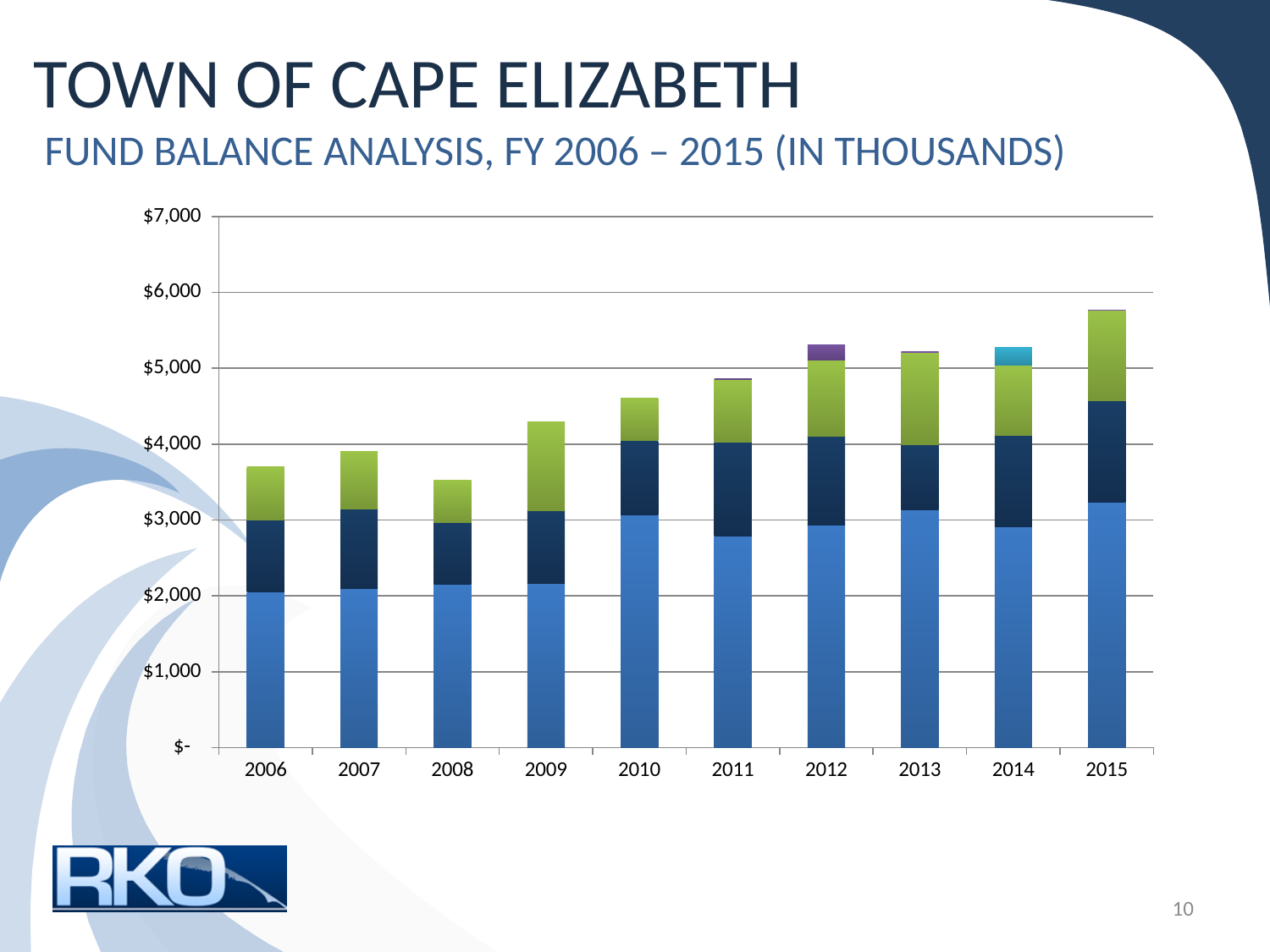
Is the total bar for 2006 greater or less than $4,000? less What kind of chart is shown on the slide? Stacked bar chart Which year has the larger total bar, 2008 or 2009? 2009 Do the total bars generally rise or fall from 2006 to 2015? Rise What is the highest value shown on the vertical axis? $7,000 Is the total bar for 2015 greater or less than $5,000? greater Is the total bar for 2010 greater or less than $4,000? greater How many fiscal years are plotted on the x axis? 10 Which year has the tallest total bar? 2015 Which year has the larger total bar, 2014 or 2015? 2015 Which year has the shortest total bar? 2008